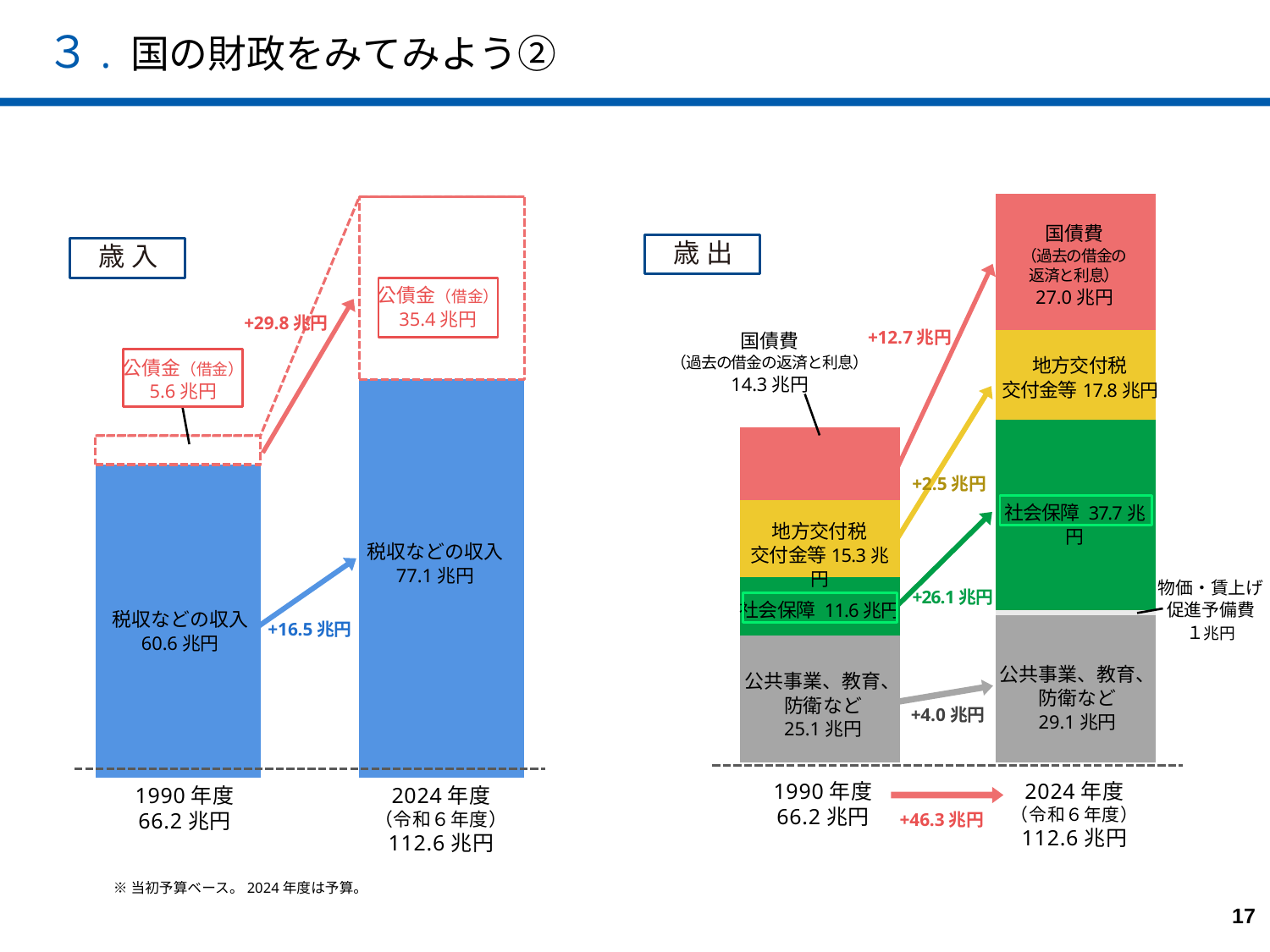
歳出のグラフで、1990年度の歳出合計はいくらですか？ 66.2兆円 歳出のグラフで、1990年度から2024年度にかけて社会保障はいくら増えましたか？ +26.1兆円 歳出のグラフで、2024年度の社会保障はいくらですか？ 37.7兆円 歳入のグラフで、1990年度の公債金（借金）はいくらですか？ 5.6兆円 歳入のグラフで、1990年度から2024年度にかけて公債金（借金）はいくら増えましたか？ +29.8兆円 歳入のグラフで、2024年度の税収などの収入はいくらですか？ 77.1兆円 歳出のグラフで、2024年度に最も金額が小さい項目は何ですか？ 物価・賃上げ促進予備費 歳出のグラフで、1990年度の地方交付税交付金等と社会保障では、どちらが大きいですか？ 地方交付税交付金等 歳出のグラフで、2024年度に最も金額が大きい項目は何ですか？ 社会保障 歳入のグラフで、1990年度の税収などの収入と公債金（借金）では、どちらが大きいですか？ 税収などの収入 歳入のグラフで、2024年度の歳入合計はいくらですか？ 112.6兆円 歳出のグラフで、1990年度の国債費（過去の借金の返済と利息）はいくらですか？ 14.3兆円